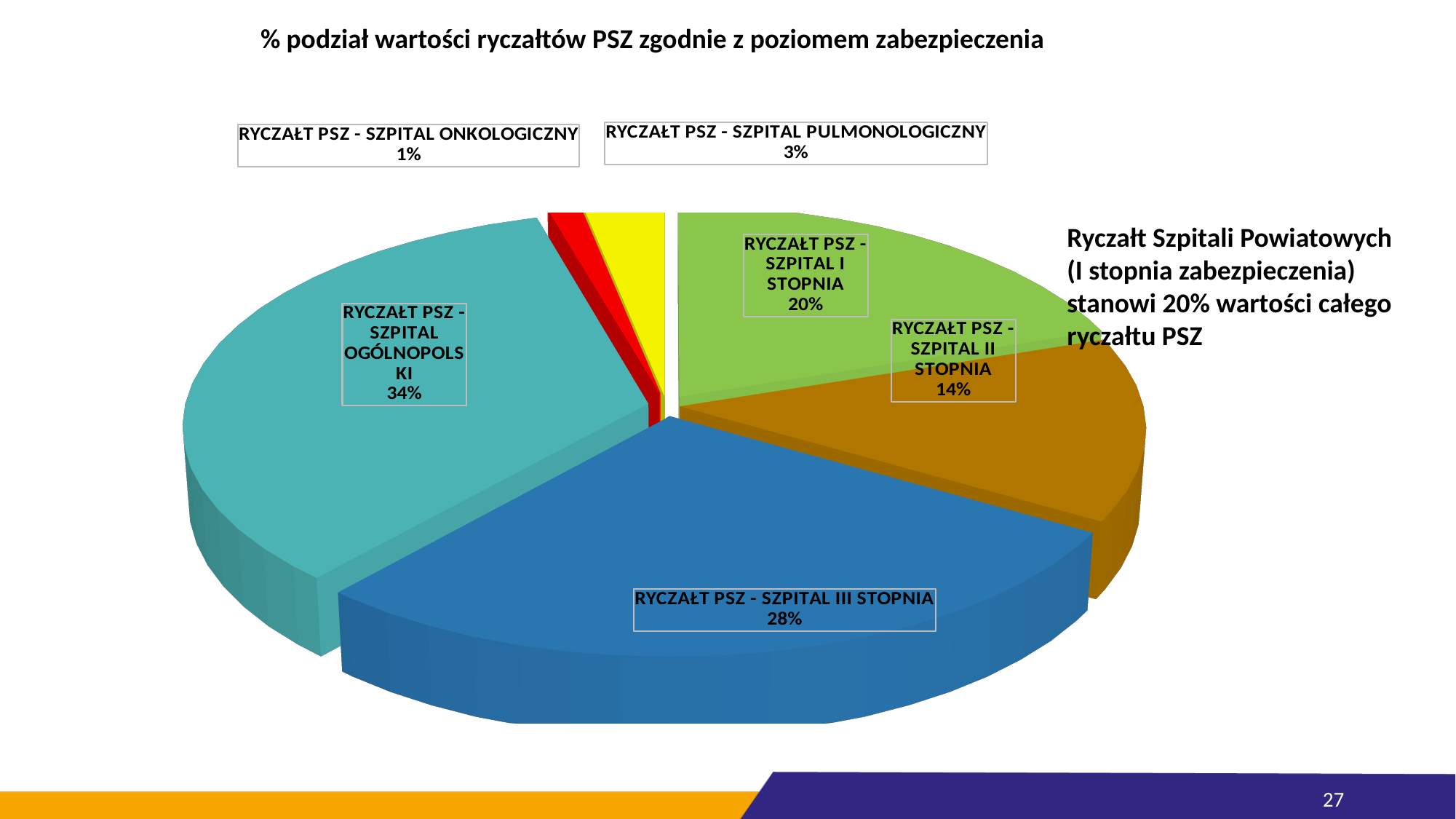
What is the title of the chart? % podział wartości ryczałtów PSZ zgodnie z poziomem zabezpieczenia What is the value shown for RYCZAŁT PSZ - SZPITAL II STOPNIA? 14% Which is larger, the share for RYCZAŁT PSZ - SZPITAL I STOPNIA or for RYCZAŁT PSZ - SZPITAL PULMONOLOGICZNY? RYCZAŁT PSZ - SZPITAL I STOPNIA What is the value shown for RYCZAŁT PSZ - SZPITAL III STOPNIA? 28% How many slices does the pie chart have? 6 What is the difference between the shares of RYCZAŁT PSZ - SZPITAL III STOPNIA and RYCZAŁT PSZ - SZPITAL II STOPNIA? 14% Which category has the largest slice of the pie? RYCZAŁT PSZ - SZPITAL OGÓLNOPOLSKI What kind of chart is shown on the slide? pie chart Which category has the smallest slice of the pie? RYCZAŁT PSZ - SZPITAL ONKOLOGICZNY What share of the pie does RYCZAŁT PSZ - SZPITAL OGÓLNOPOLSKI have? 34% What is the value shown for RYCZAŁT PSZ - SZPITAL I STOPNIA? 20% What is the value shown for RYCZAŁT PSZ - SZPITAL PULMONOLOGICZNY? 3%